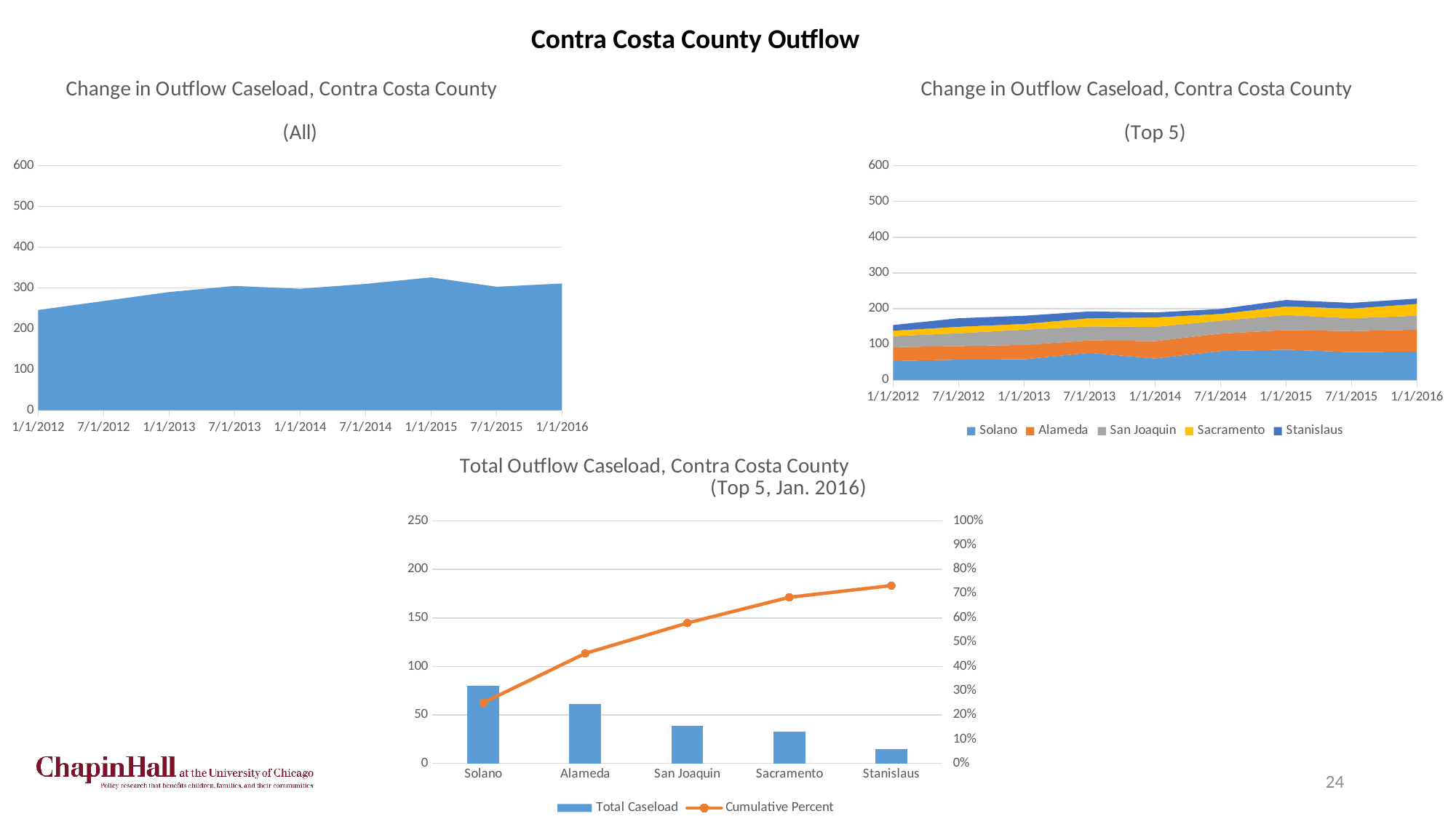
In the 'Total Outflow Caseload, Contra Costa County (Top 5, Jan. 2016)' chart, is the Cumulative Percent for Alameda greater or less than 50%? less In the 'Change in Outflow Caseload, Contra Costa County (All)' chart, does the caseload generally rise or fall from 1/1/2012 to 1/1/2015? rise In the 'Change in Outflow Caseload, Contra Costa County (All)' chart, is the value at 1/1/2015 greater or less than 300? greater In the 'Total Outflow Caseload, Contra Costa County (Top 5, Jan. 2016)' chart, which county has the lowest Total Caseload? Stanislaus What kind of chart is the 'Change in Outflow Caseload, Contra Costa County (All)' chart? area chart In the 'Total Outflow Caseload, Contra Costa County (Top 5, Jan. 2016)' chart, how many counties are shown on the x axis? 5 In the 'Total Outflow Caseload, Contra Costa County (Top 5, Jan. 2016)' chart, which county has the highest Total Caseload? Solano How many series does the legend of the 'Change in Outflow Caseload, Contra Costa County (Top 5)' chart list? 5 In the 'Change in Outflow Caseload, Contra Costa County (Top 5)' chart, is the stacked total at 1/1/2016 greater or less than 200? greater In the 'Change in Outflow Caseload, Contra Costa County (Top 5)' chart, which series is shown at the bottom of the stack? Solano